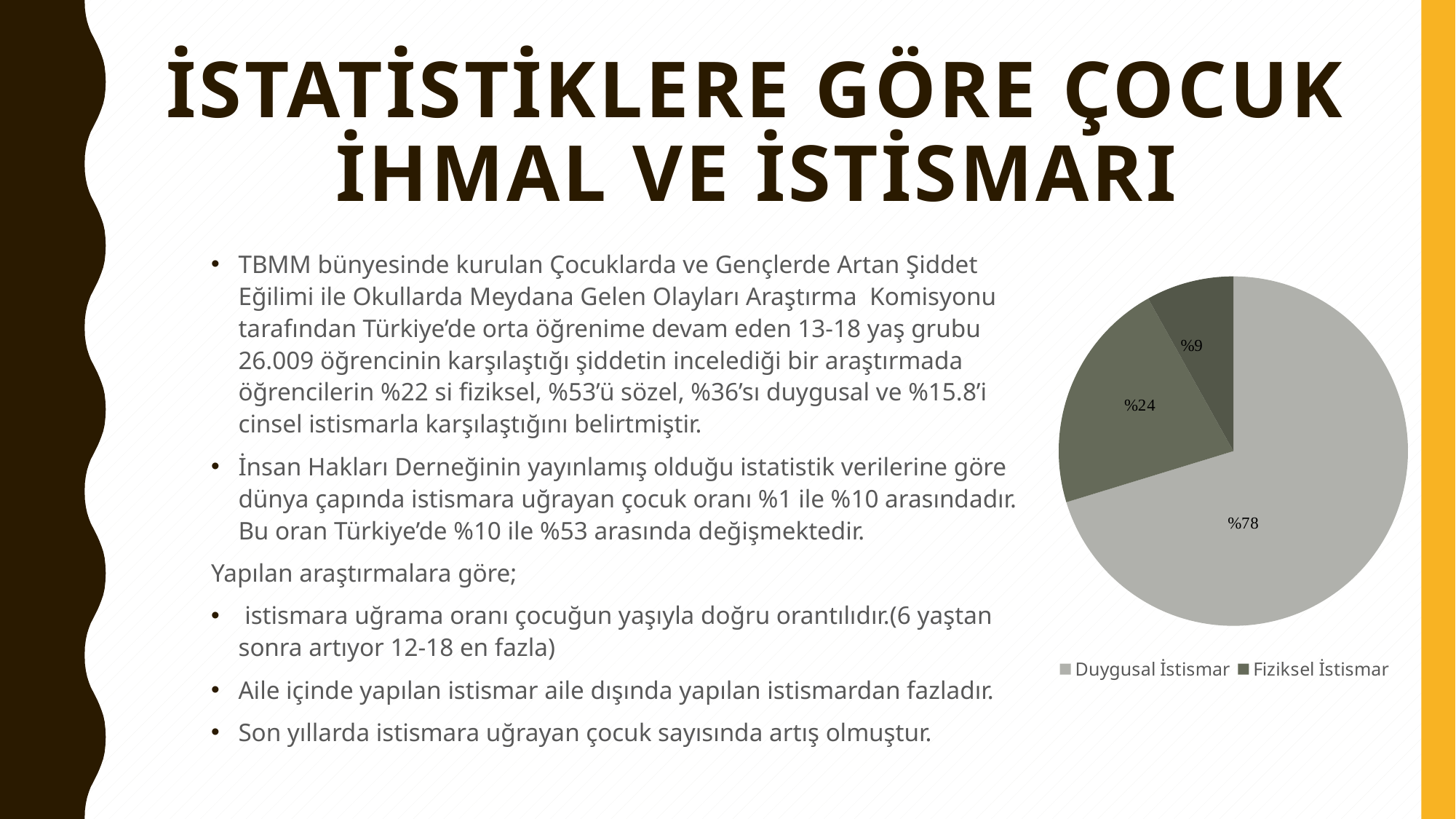
What share of the pie chart is labelled Duygusal İstismar? %78 Which legend category has the largest slice in the pie chart? Duygusal İstismar What kind of chart is shown on the slide? pie chart What are the two entries listed in the pie chart's legend? Duygusal İstismar, Fiziksel İstismar Which is larger in the pie chart, Duygusal İstismar or Fiziksel İstismar? Duygusal İstismar What share of the pie chart is labelled Fiziksel İstismar? %24 How many entries does the pie chart's legend list? 2 Is the Fiziksel İstismar slice greater or less than %50 of the pie? less How many slices does the pie chart have? 3 By how many percentage points does the Duygusal İstismar slice exceed the Fiziksel İstismar slice? 54 What is the value printed on the largest slice of the pie chart? %78 What is the value printed on the smallest slice of the pie chart? %9